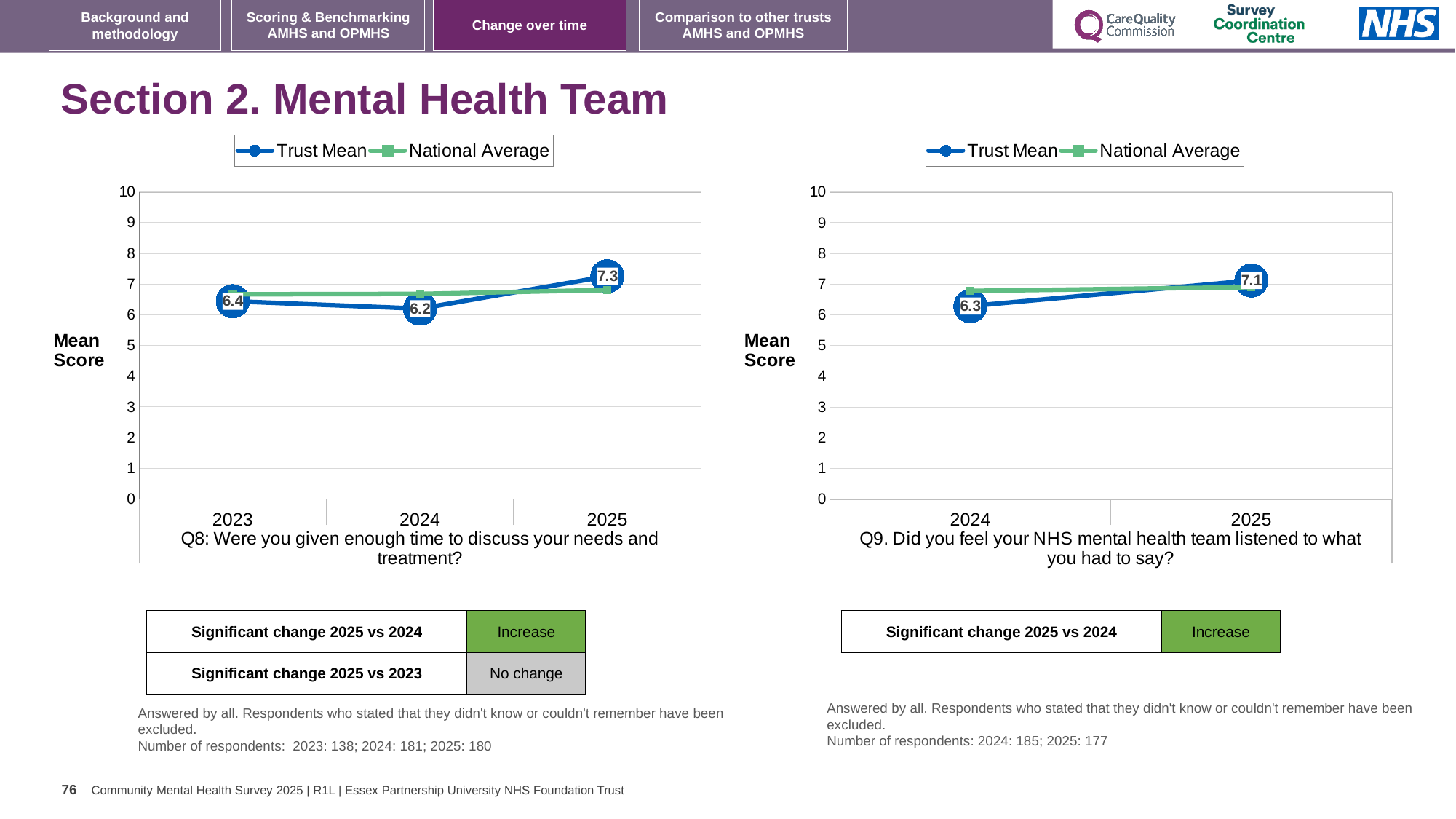
In the Q8 chart (left), which year has the highest Trust Mean score? 2025 In the Q8 chart (left), which year has the lowest Trust Mean score? 2024 How many series does the legend of the Q9 chart (right) list? 2 In the Q8 chart (left), what is the Trust Mean score for 2023? 6.4 In the Q9 chart (right), is the National Average value for 2024 greater or less than 6? greater What kind of chart is the Q9 chart (right)? Line chart In the Q8 chart (left), what is the difference between the Trust Mean scores for 2025 and 2024? 1.1 How many years are shown on the x axis of the Q8 chart (left)? 3 In the Q9 chart (right), is the Trust Mean for 2025 greater or less than the Trust Mean for 2024? greater In the Q8 chart (left), what is the Trust Mean score for 2025? 7.3 In the Q9 chart (right), what is the difference between the Trust Mean scores for 2025 and 2024? 0.8 In the Q9 chart (right), what is the Trust Mean score for 2024? 6.3